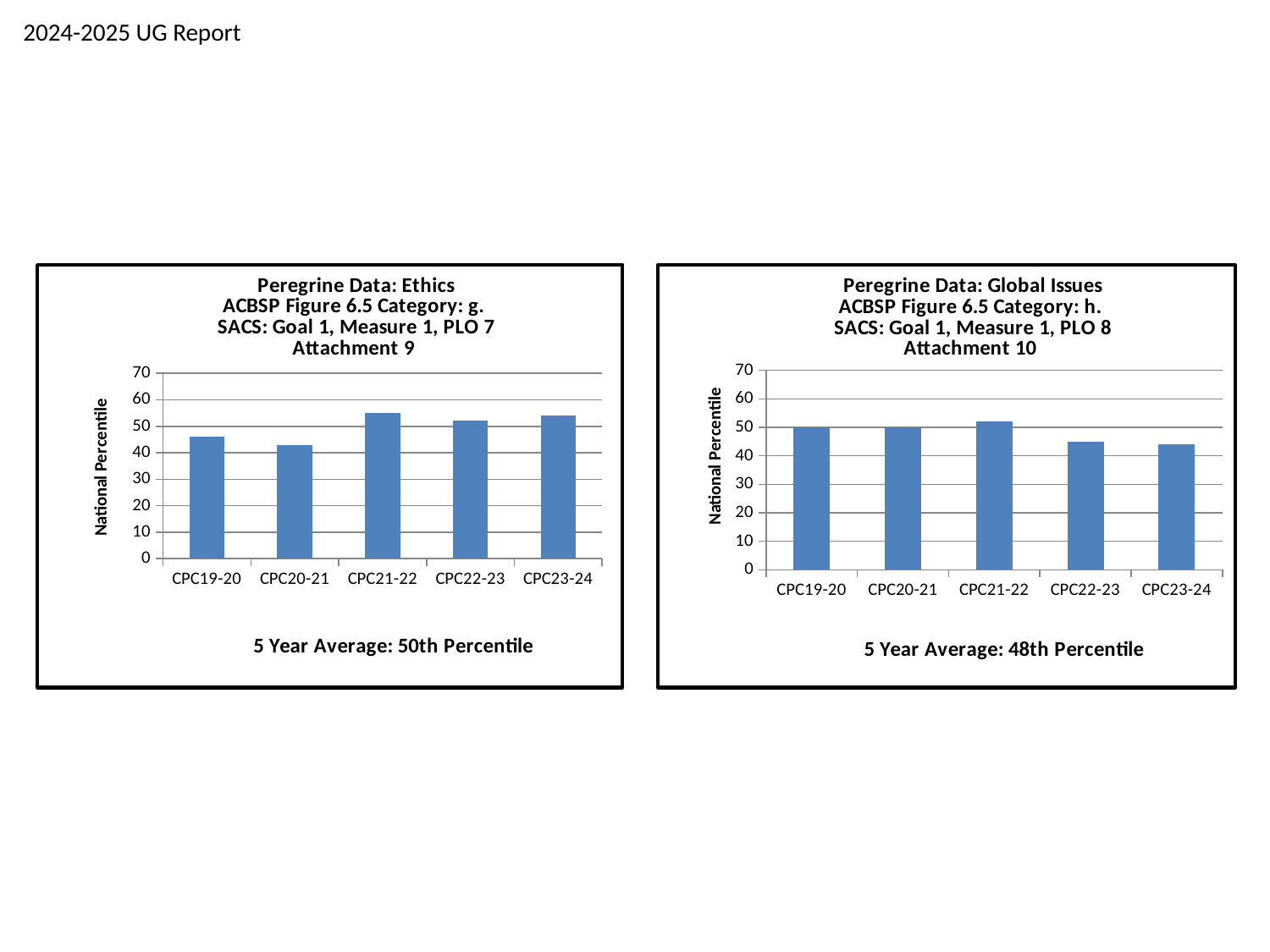
On the Peregrine Data: Ethics chart, how many categories are shown on the x axis? 5 On the Peregrine Data: Ethics chart, which category has the lowest value? CPC20-21 On the Peregrine Data: Global Issues chart, is the value for CPC22-23 greater or less than 50? less What kind of chart is the Peregrine Data: Global Issues chart? bar chart What 5 year average is stated below the Peregrine Data: Global Issues chart? 48th Percentile On the Peregrine Data: Global Issues chart, which is larger, the value for CPC21-22 or the value for CPC23-24? CPC21-22 On the Peregrine Data: Ethics chart, is the value for CPC20-21 greater or less than 50? less What is the y-axis title on the Peregrine Data: Ethics chart? National Percentile On the Peregrine Data: Ethics chart, is the value for CPC21-22 greater or less than 50? greater On the Peregrine Data: Ethics chart, which is larger, the value for CPC19-20 or the value for CPC21-22? CPC21-22 On the Peregrine Data: Global Issues chart, how many bars are plotted? 5